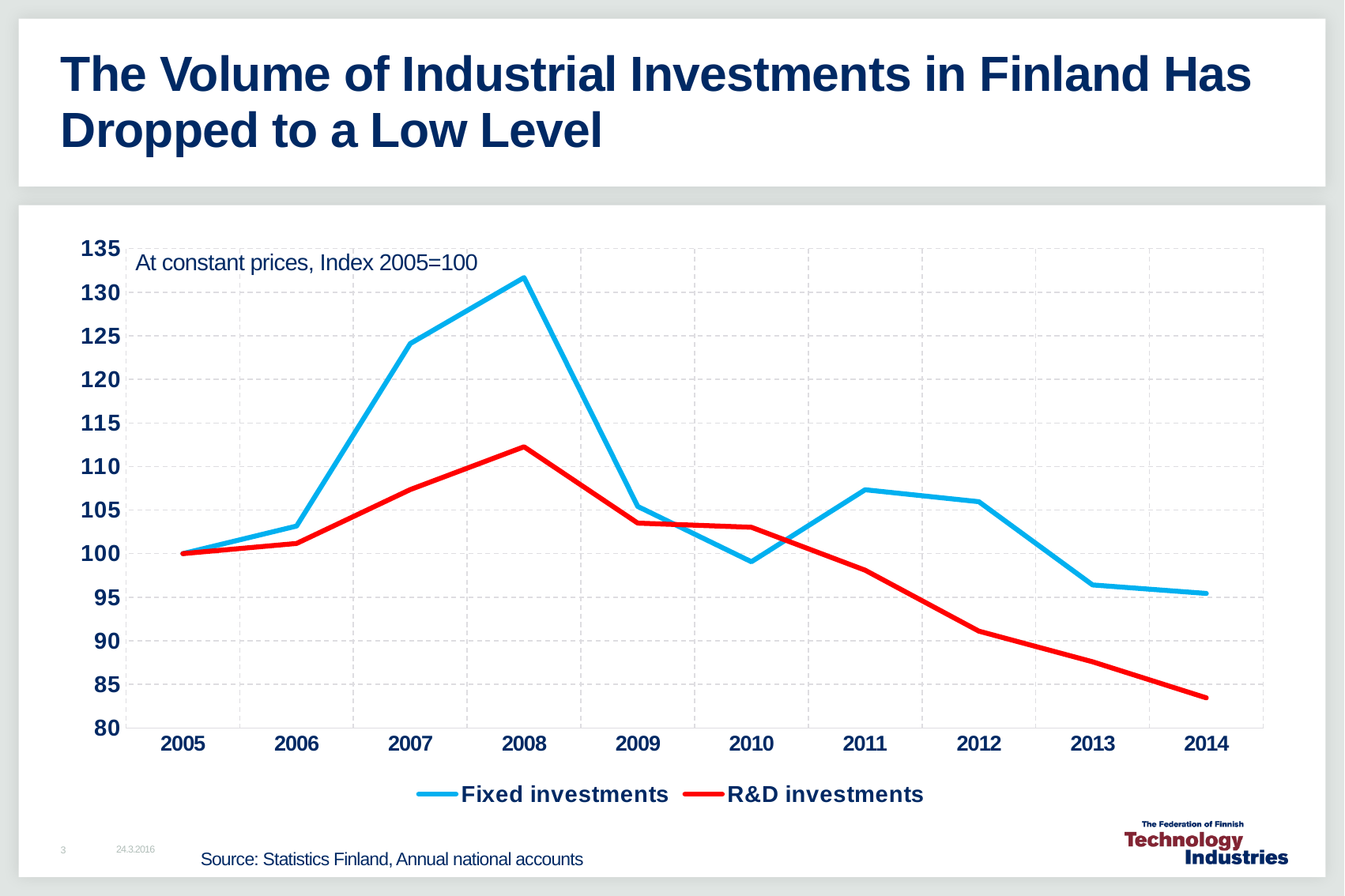
How many series does the legend list? 2 Is the value for Fixed investments in 2008 greater or less than 130? greater What index base is stated in the note at the top of the chart? Index 2005=100 How many years are plotted along the x axis? 10 Is the value for Fixed investments in 2010 greater or less than 100? less What kind of chart is shown on the slide? Line chart In which year do R&D investments reach their lowest value? 2014 Which series has the larger value in 2012, Fixed investments or R&D investments? Fixed investments Do R&D investments rise or fall from 2008 to 2014? Fall What is the value of Fixed investments in 2005? 100 Is the value for R&D investments in 2014 greater or less than 85? less In which year do Fixed investments reach their highest value? 2008